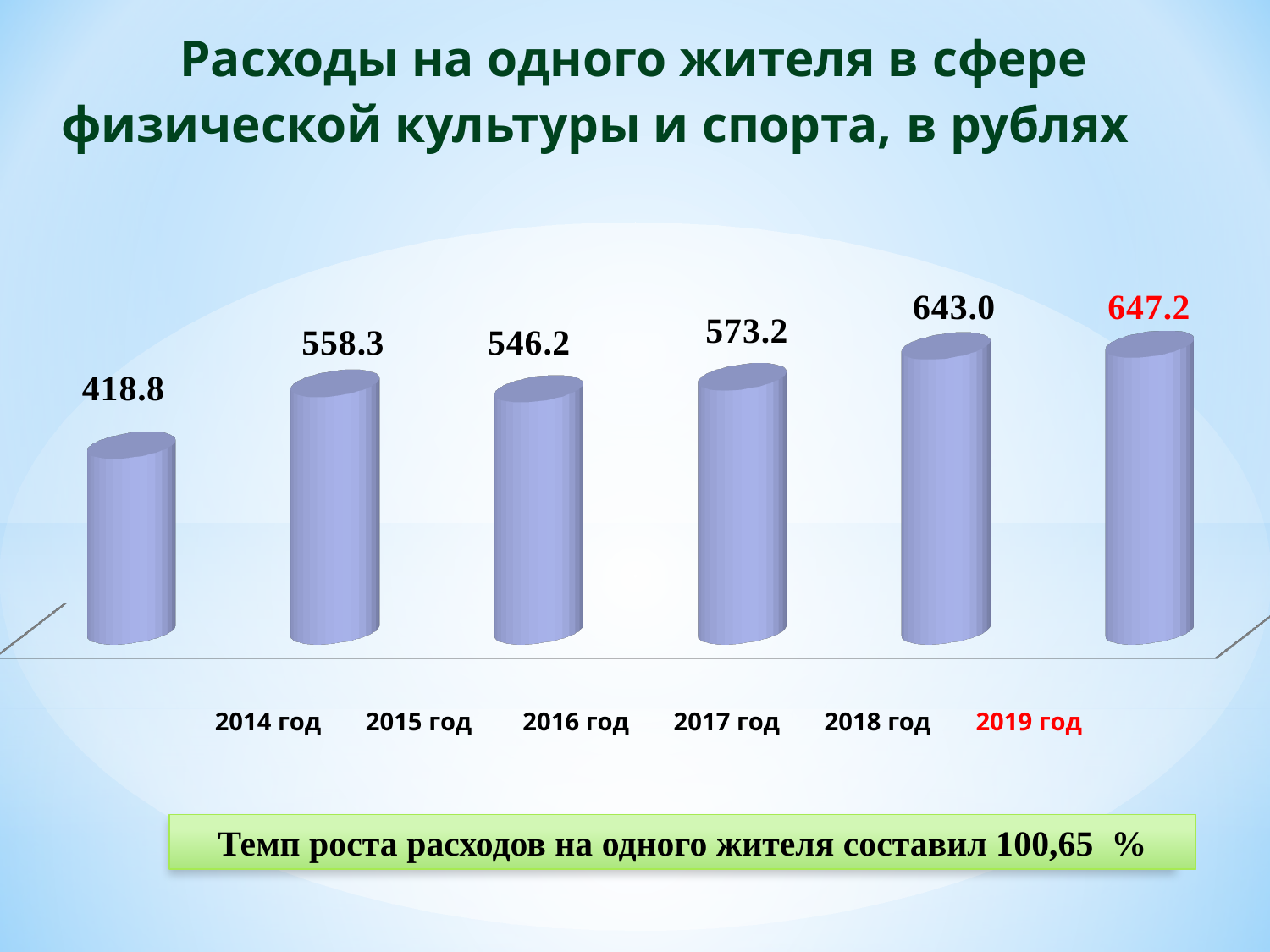
Which is larger, the value for 2015 год or the value for 2016 год? 2015 год What is the value for 2019 год? 647.2 What is the value for 2014 год? 418.8 Which year's label and value are shown in red on the chart? 2019 год What is the difference between the values for 2015 год and 2014 год? 139.5 How many years are shown on the chart? 6 What kind of chart is shown on the slide? bar chart Do the values generally rise or fall from 2014 год to 2019 год? rise What is the difference between the values for 2019 год and 2018 год? 4.2 Which year has the lowest value? 2014 год Which year has the highest value? 2019 год What is the value for 2016 год? 546.2